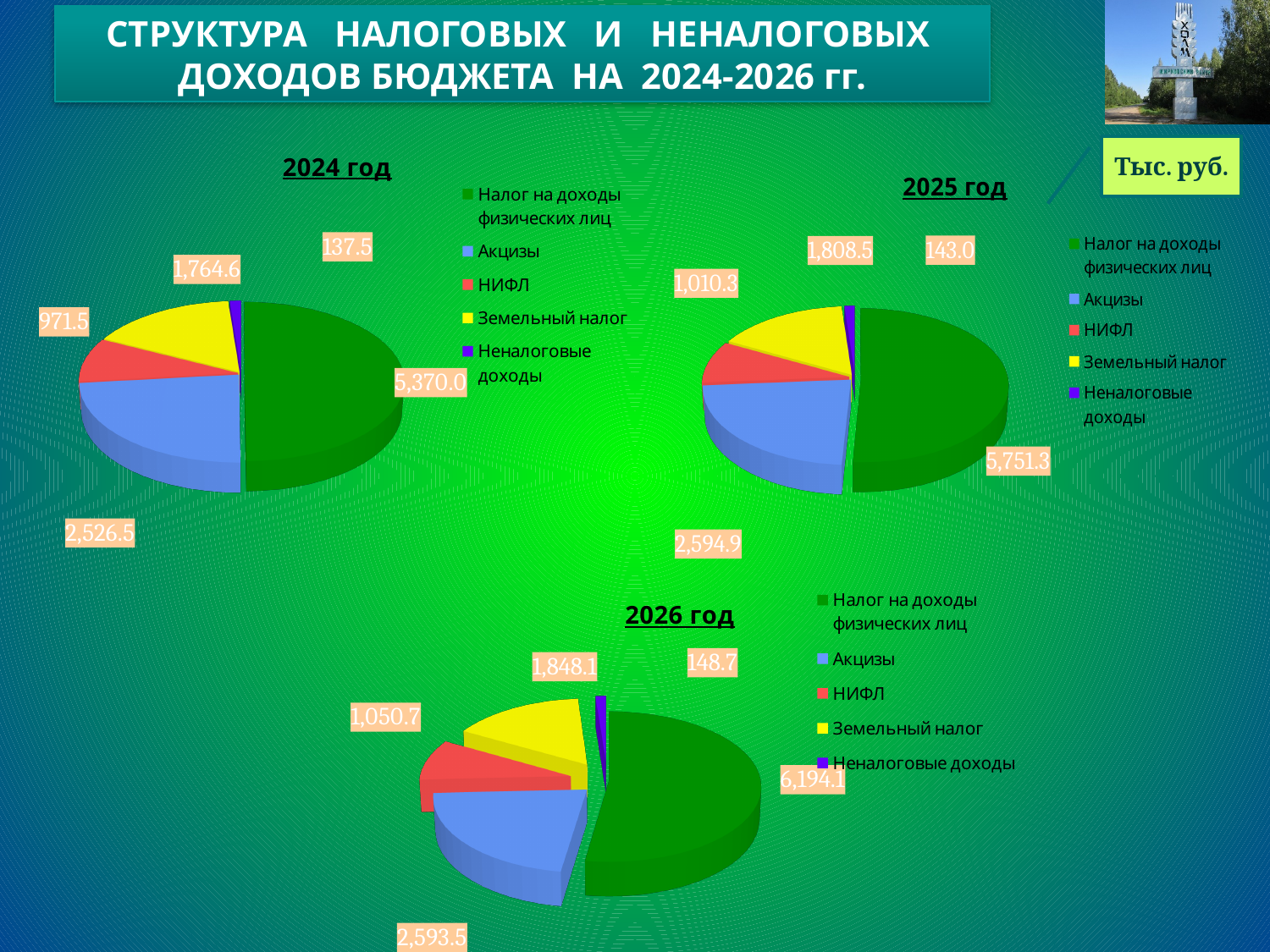
On the 2024 год chart, what is the value for Налог на доходы физических лиц? 5,370.0 On the 2025 год chart, which is larger: Земельный налог or НИФЛ? Земельный налог On the 2025 год chart, which category has the smallest slice? Неналоговые доходы What type of chart is used for 2026 год? Pie chart On the 2024 год chart, what is the difference between Налог на доходы физических лиц and Акцизы? 2,843.5 On the 2024 год chart, what is the value for Неналоговые доходы? 137.5 On the 2026 год chart, what is the difference between Земельный налог and НИФЛ? 797.4 On the 2026 год chart, what is the value for Земельный налог? 1,848.1 How many categories does the 2024 год chart show? 5 On the 2026 год chart, which category has the largest slice? Налог на доходы физических лиц On the 2025 год chart, what colour is the Акцизы slice? Blue On the 2025 год chart, what is the value for Акцизы? 2,594.9